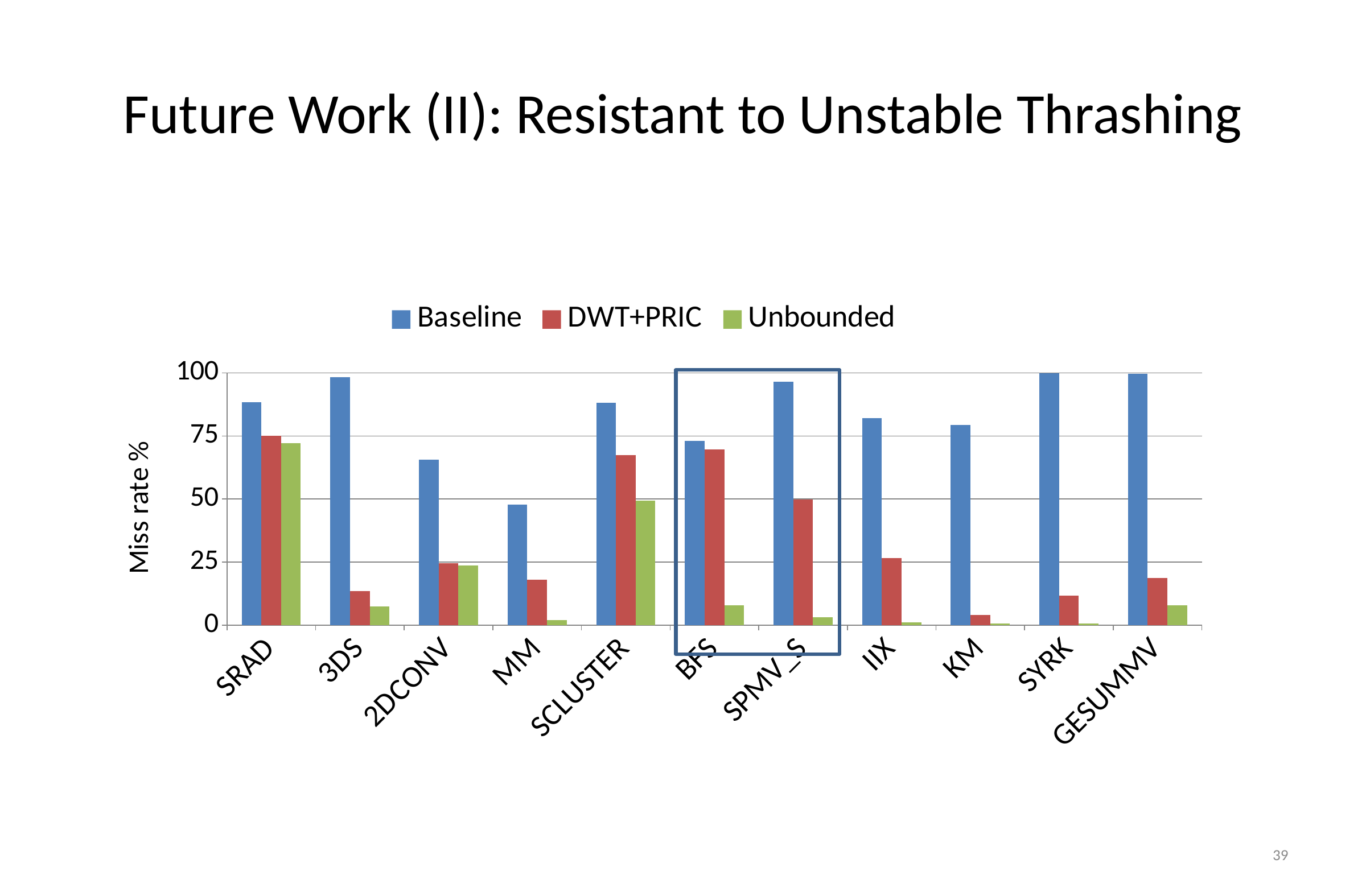
Which is larger, the Baseline value for SRAD or the Baseline value for 3DS? 3DS How many series does the legend list? 3 Which category has the lowest DWT+PRIC miss rate? KM Is the DWT+PRIC value for SYRK greater or less than 25? less Which category has the highest Unbounded miss rate? SRAD What is the label on the y axis of the chart? Miss rate % Which is larger, the DWT+PRIC value for BFS or the DWT+PRIC value for SPMV_S? BFS Is the Baseline value for 3DS greater or less than 75? greater Which category has the lowest Baseline miss rate? MM What kind of chart is shown on the slide? bar chart How many categories are shown along the x axis? 11 Is the Baseline value for MM greater or less than 50? less